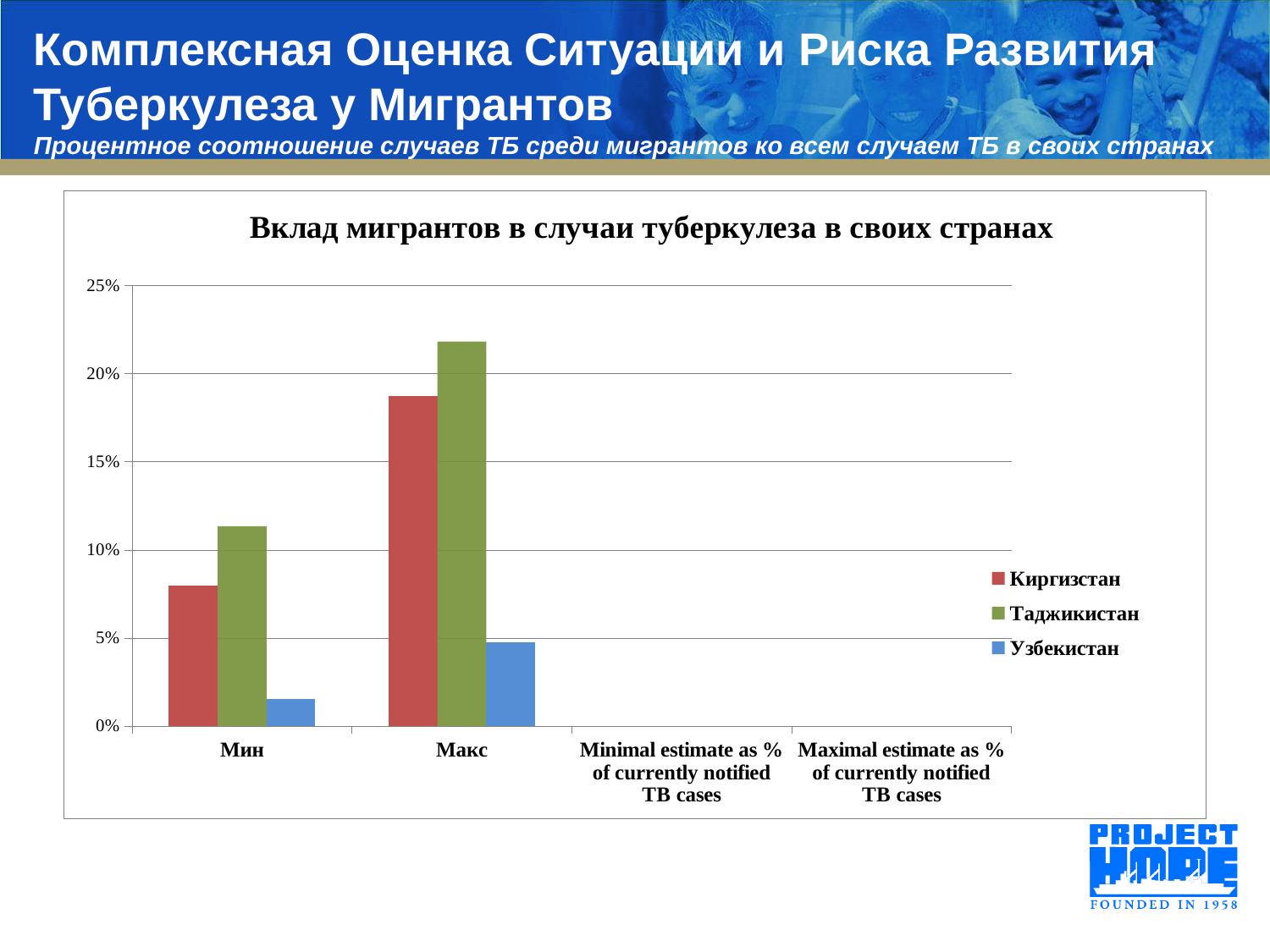
How many series does the legend list? 3 Is the value for Таджикистан in the Макс category greater or less than 20%? greater What kind of chart is shown on the slide? bar chart What is the title of the chart? Вклад мигрантов в случаи туберкулеза в своих странах Which series has the highest value in the Макс category? Таджикистан Is the value for Таджикистан in the Мин category greater or less than 10%? greater Which is larger: the value for Киргизстан in Мин or the value for Киргизстан in Макс? Макс Do the values for each series rise or fall from the Мин category to the Макс category? rise Which series does the legend show in green? Таджикистан Is the value for Киргизстан in the Макс category greater or less than 20%? less Which series has the lowest value in the Мин category? Узбекистан